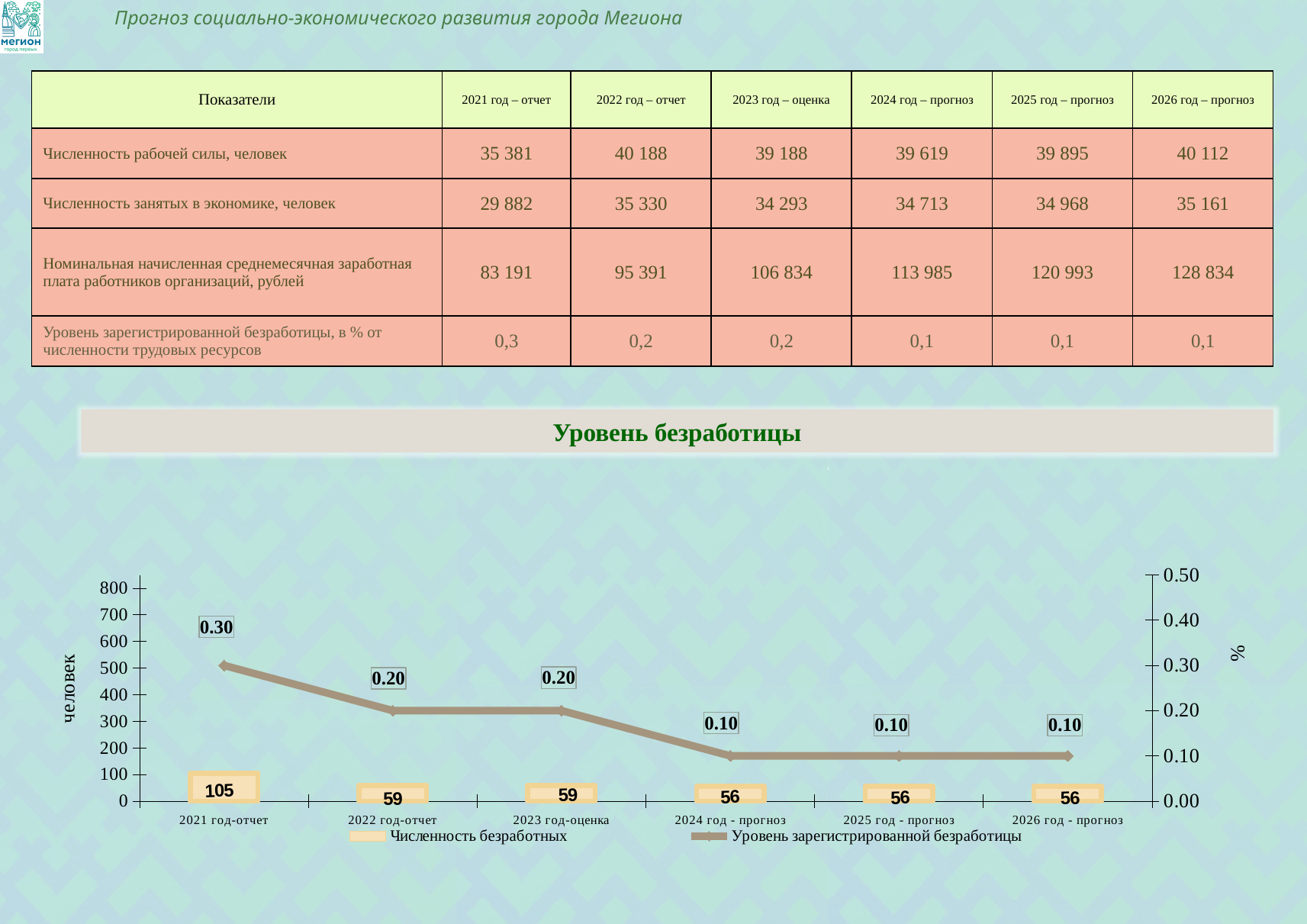
How many years (categories) are shown on the x axis of the chart 'Уровень безработицы'? 6 In the chart 'Уровень безработицы', what is the difference in 'Уровень зарегистрированной безработицы' between '2021 год-отчет' and '2026 год - прогноз'? 0.20 In the chart 'Уровень безработицы', what is the value of 'Численность безработных' for '2026 год - прогноз'? 56 In the chart 'Уровень безработицы', what is the difference in 'Численность безработных' between '2021 год-отчет' and '2022 год-отчет'? 46 How many series does the legend of the chart 'Уровень безработицы' list? 2 In the chart 'Уровень безработицы', what is the value of 'Численность безработных' for '2021 год-отчет'? 105 In the chart 'Уровень безработицы', which year has the highest value of 'Уровень зарегистрированной безработицы'? 2021 год-отчет In the chart 'Уровень безработицы', what is the value of 'Уровень зарегистрированной безработицы' for '2024 год - прогноз'? 0.10 In the chart 'Уровень безработицы', does 'Уровень зарегистрированной безработицы' rise or fall from 2021 to 2026? fall In the chart 'Уровень безработицы', is 'Численность безработных' larger for '2023 год-оценка' or for '2024 год - прогноз'? 2023 год-оценка In the chart 'Уровень безработицы', what is the value of 'Уровень зарегистрированной безработицы' for '2022 год-отчет'? 0.20 In the chart 'Уровень безработицы', which year has the highest value of 'Численность безработных'? 2021 год-отчет